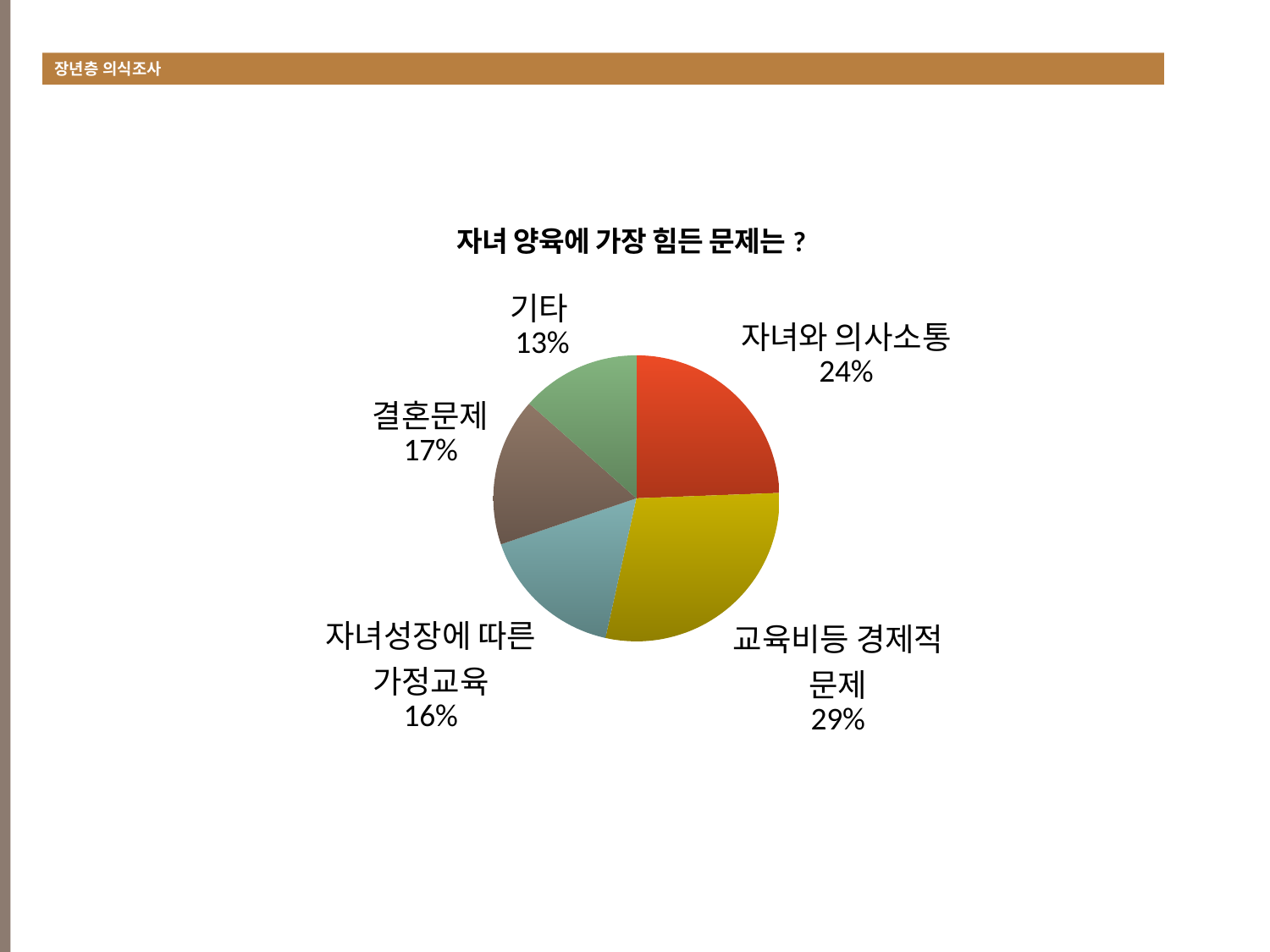
Which category has the smallest share of the pie? 기타 Which category has the largest share of the pie? 교육비등 경제적 문제 What percentage is shown for 자녀성장에 따른 가정교육? 16% How many slices does the pie chart have? 5 What is the title of the chart? 자녀 양육에 가장 힘든 문제는 ? What percentage is shown for 결혼문제? 17% Which is larger, the share for 결혼문제 or the share for 기타? 결혼문제 What percentage is shown for 교육비등 경제적 문제? 29% What percentage is shown for 기타? 13% What is the difference in percentage points between 교육비등 경제적 문제 and 자녀와 의사소통? 5 What type of chart is shown on the slide? pie chart What percentage is shown for 자녀와 의사소통? 24%